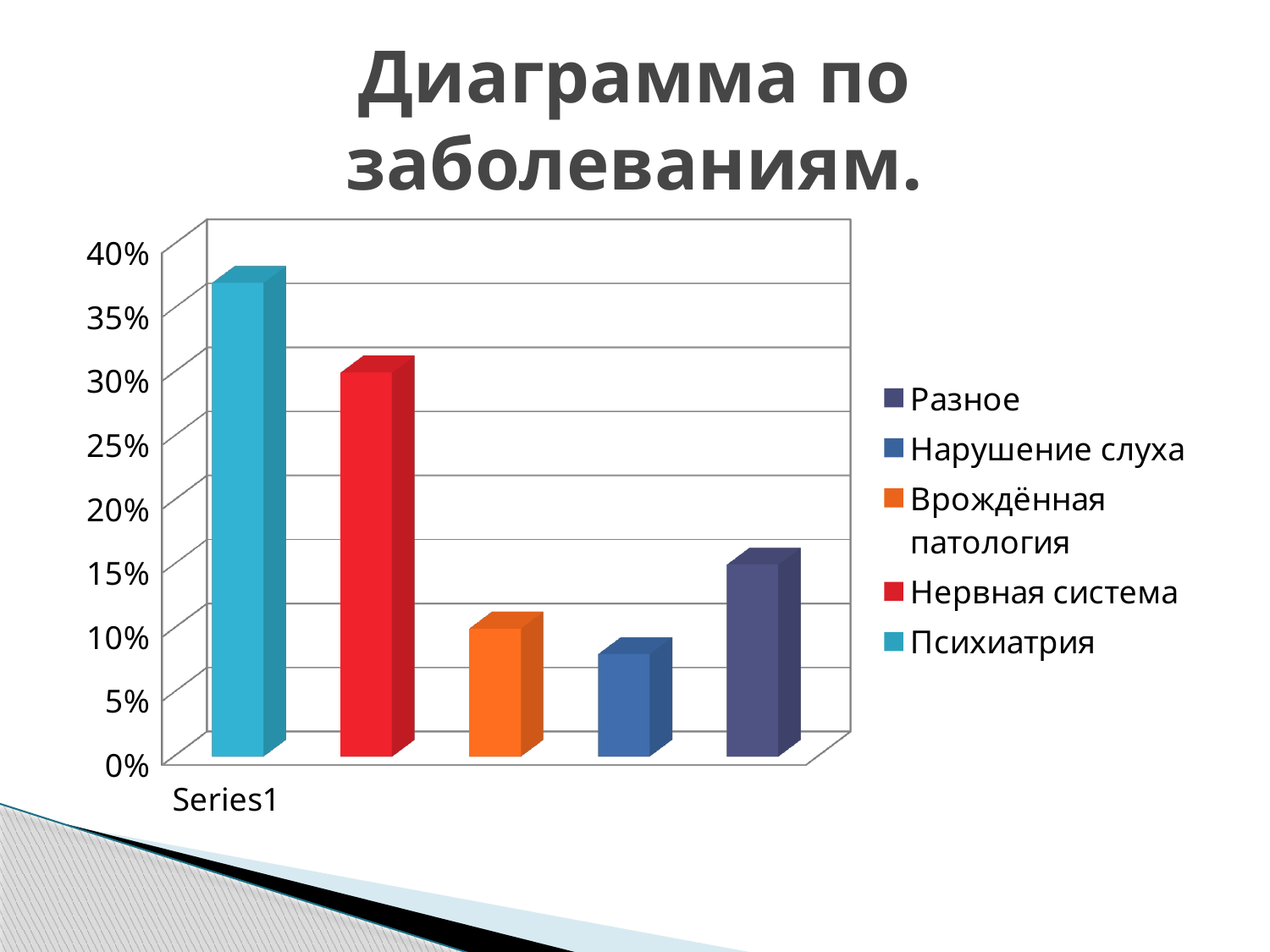
How many bars are plotted in the chart? 5 Which is larger, the value for Нервная система or the value for Разное? Нервная система How many series does the legend list? 5 Which series has the highest bar? Психиатрия Is the value for Психиатрия greater or less than 35%? greater Which series has the lowest bar? Нарушение слуха Which colour represents Психиатрия in the legend? light blue Is the value for Нервная система greater or less than 25%? greater What kind of chart is shown on the slide? bar chart Is the value for Разное greater or less than 20%? less What is the title of the chart? Диаграмма по заболеваниям.